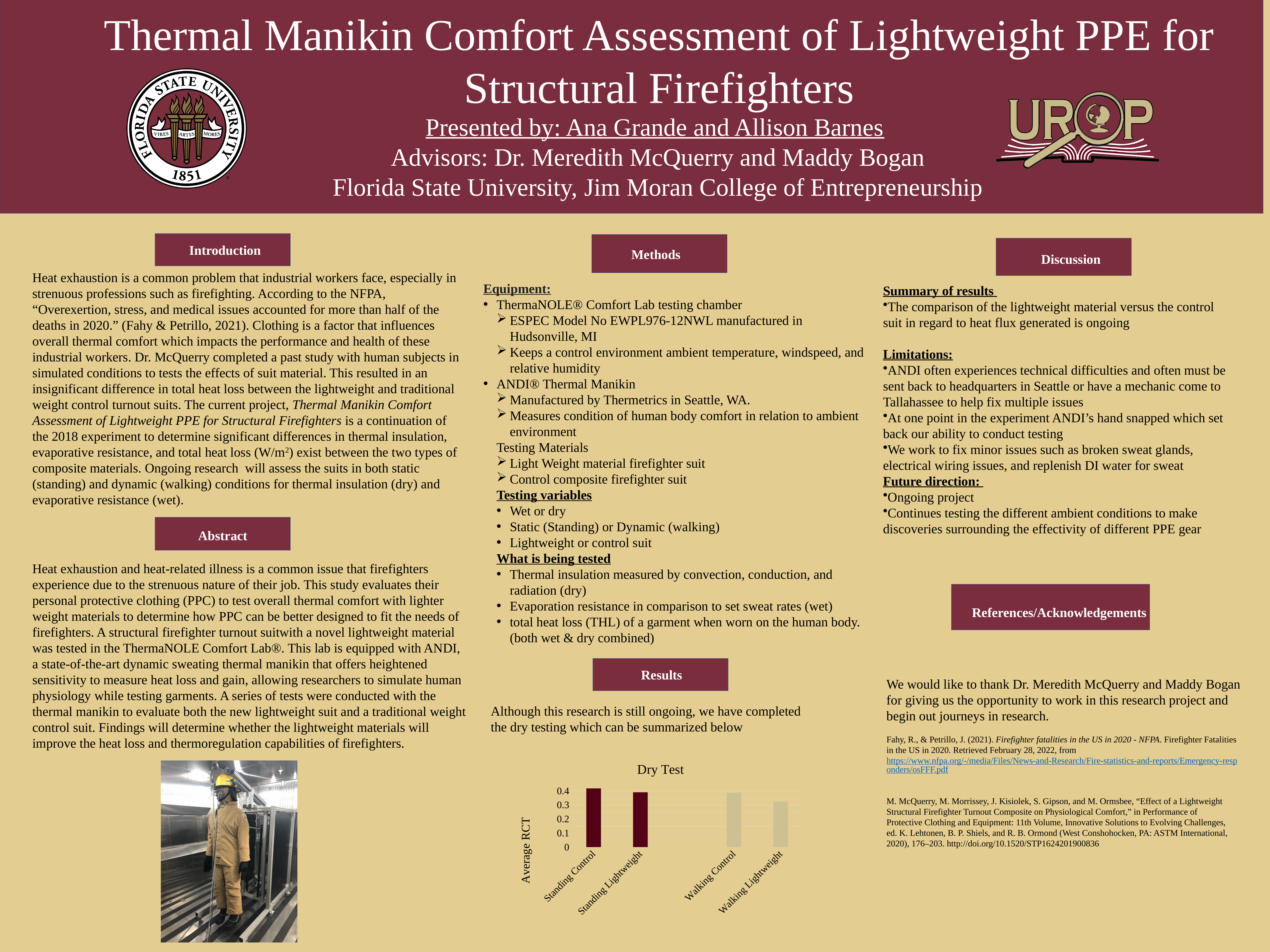
In the Dry Test chart, which is larger: the value for Standing Control or the value for Walking Lightweight? Standing Control What is the label on the y axis of the Dry Test chart? Average RCT How many categories are shown on the x axis of the Dry Test chart? 4 What kind of chart is the Dry Test chart? bar chart Which category has the lowest Average RCT in the Dry Test chart? Walking Lightweight In the Dry Test chart, is the value for Walking Lightweight greater or less than 0.4? less In the Dry Test chart, is the value for Standing Control greater or less than 0.3? greater Do the bar values in the Dry Test chart rise or fall from left to right along the x axis? fall What is the title of the chart in the Results section? Dry Test In the Dry Test chart, is the value for Standing Lightweight greater or less than 0.3? greater